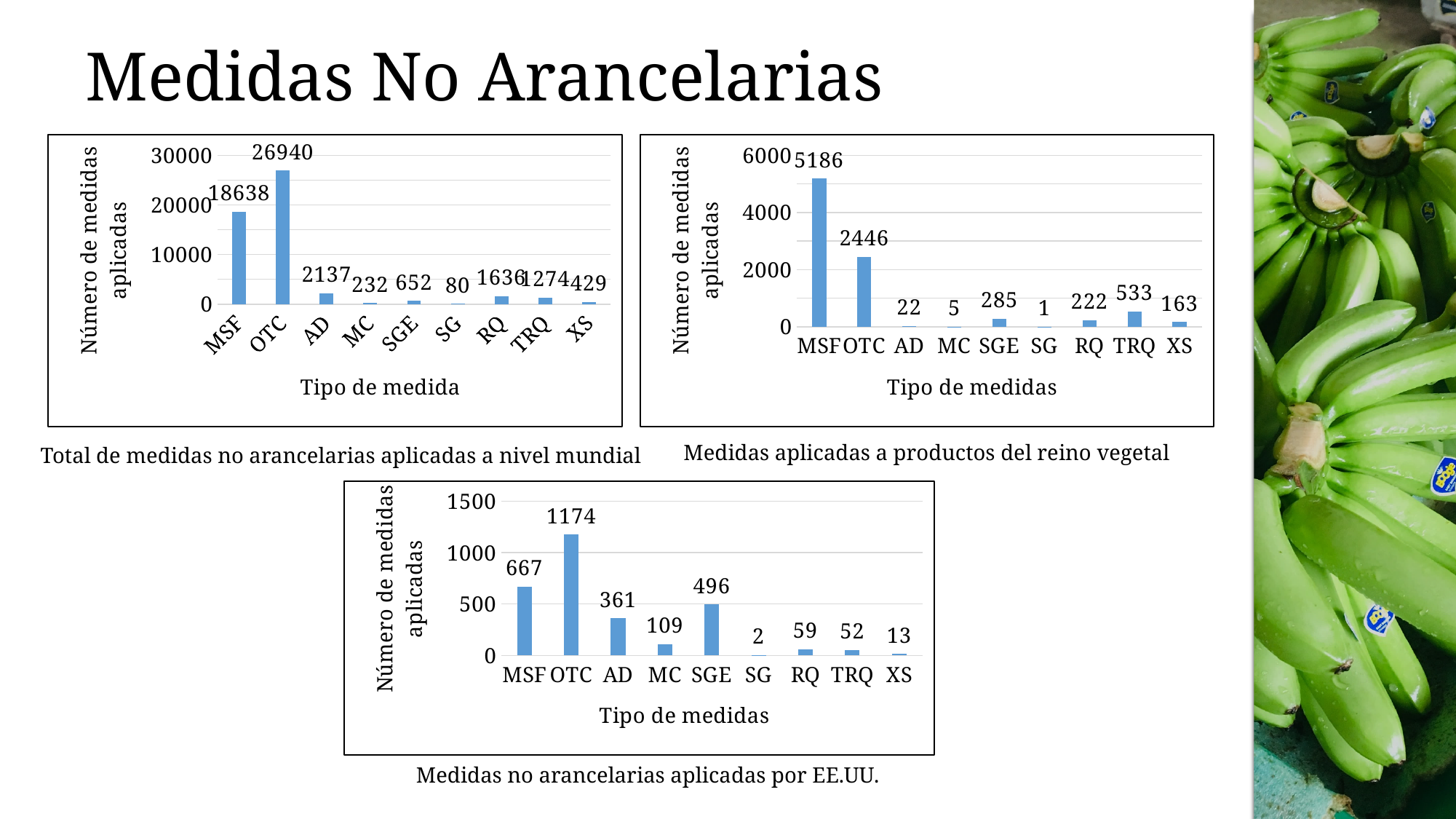
How many categories are shown on the x axis of the bottom chart (EE.UU.)? 9 In the bottom chart (EE.UU.), which category has the highest value? OTC In the top-left chart (nivel mundial), which category has the lowest value? SG What kind of chart is the top-left chart (nivel mundial)? Bar chart What is the x-axis title of the bottom chart (EE.UU.)? Tipo de medidas In the bottom chart (EE.UU.), what is the difference between the values for OTC and MSF? 507 In the top-right chart (reino vegetal), which category has the highest value? MSF In the top-right chart (reino vegetal), which is larger, the value for SGE or the value for RQ? SGE In the chart captioned 'Total de medidas no arancelarias aplicadas a nivel mundial' (top left), what is the value for OTC? 26940 In the chart captioned 'Medidas aplicadas a productos del reino vegetal' (top right), what is the value for TRQ? 533 In the chart captioned 'Medidas no arancelarias aplicadas por EE.UU.' (bottom), what is the value for SGE? 496 In the top-left chart (nivel mundial), what is the difference between the values for OTC and MSF? 8302